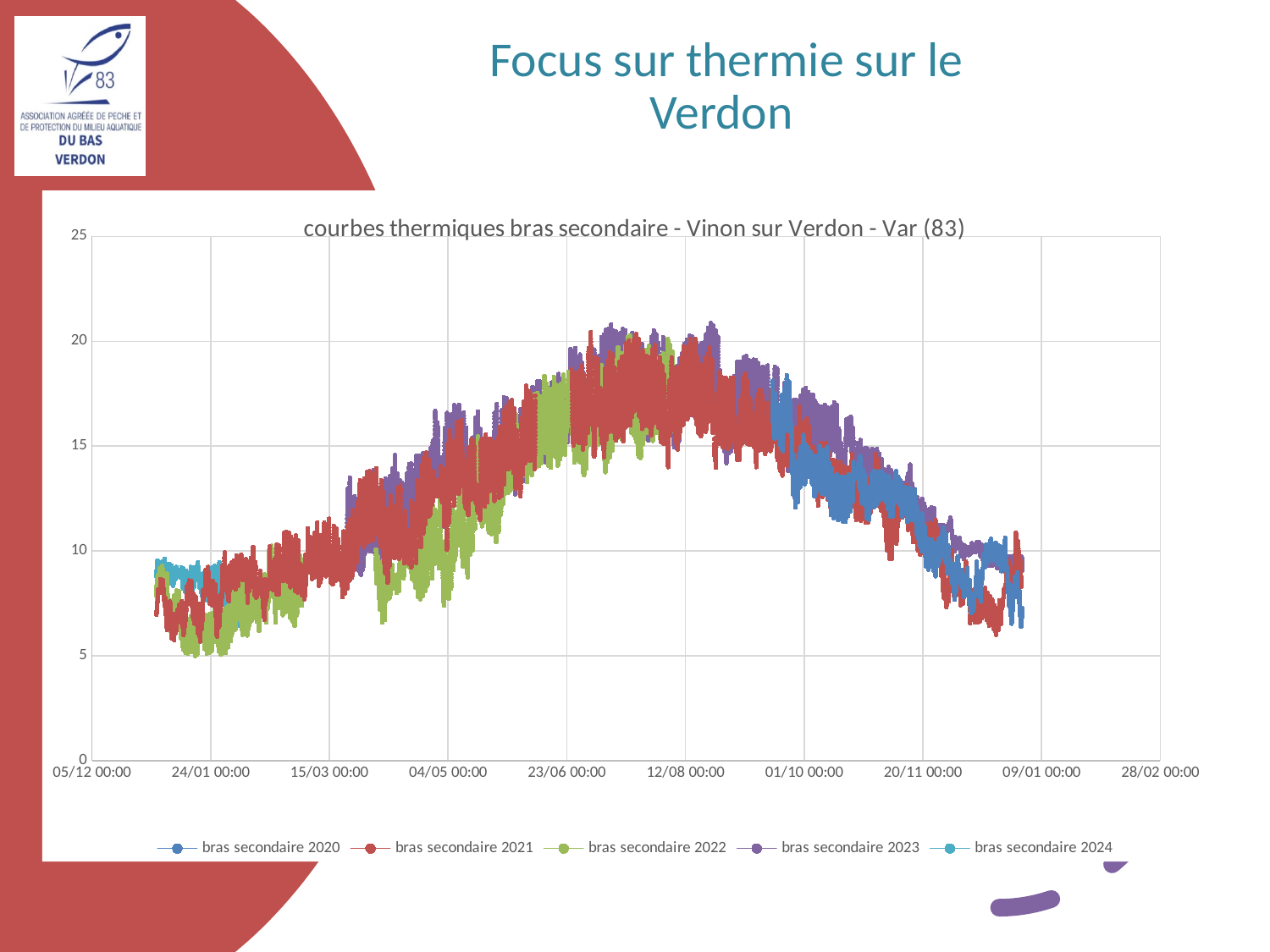
How many date labels are shown on the x axis? 10 How many series does the legend list? 5 What is the title of the chart? courbes thermiques bras secondaire - Vinon sur Verdon - Var (83) Is the highest value reached by any series greater or less than 25? less Is the value of 'bras secondaire 2024' in early January greater or less than 5? greater What kind of chart is shown on the slide? line chart Which colour is used for the series 'bras secondaire 2022'? green Is the lowest value of 'bras secondaire 2022' in late January greater or less than 10? less Do the values generally rise or fall between 15/03 and 23/06? rise Do the values generally rise or fall between 12/08 and 20/11? fall